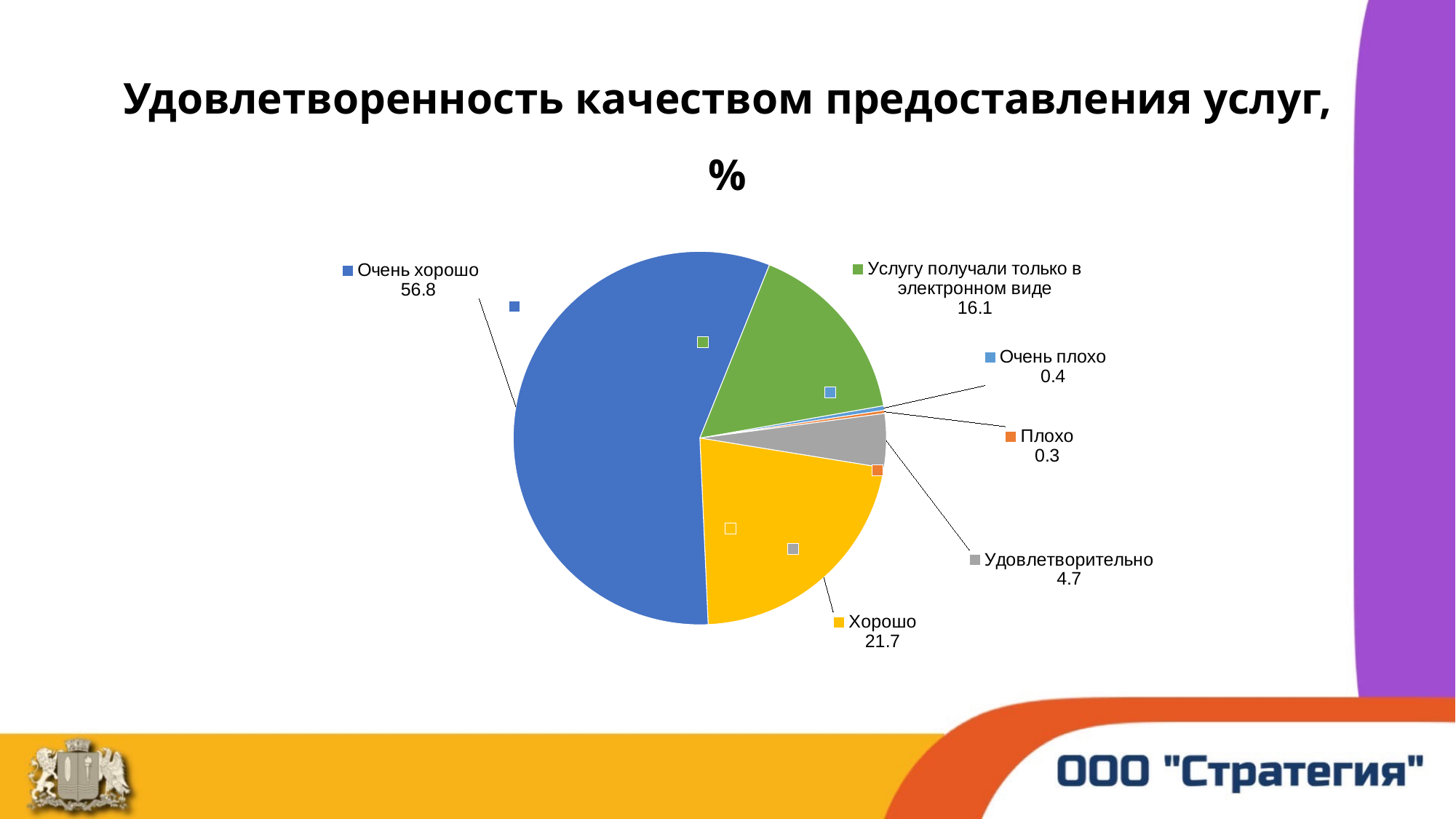
What is the value for "Хорошо"? 21.7 What is the difference between the values for "Очень хорошо" and "Хорошо"? 35.1 Which category has the smallest slice of the pie? Плохо What is the title of the chart? Удовлетворенность качеством предоставления услуг, % Which is larger, the value for "Хорошо" or the value for "Услугу получали только в электронном виде"? Хорошо What is the value for "Удовлетворительно"? 4.7 What is the value for "Услугу получали только в электронном виде"? 16.1 Which category has the largest slice of the pie? Очень хорошо What type of chart is shown on the slide? Pie chart What is the value for "Плохо"? 0.3 What is the value for "Очень хорошо"? 56.8 How many categories (slices) does the pie chart have? 6